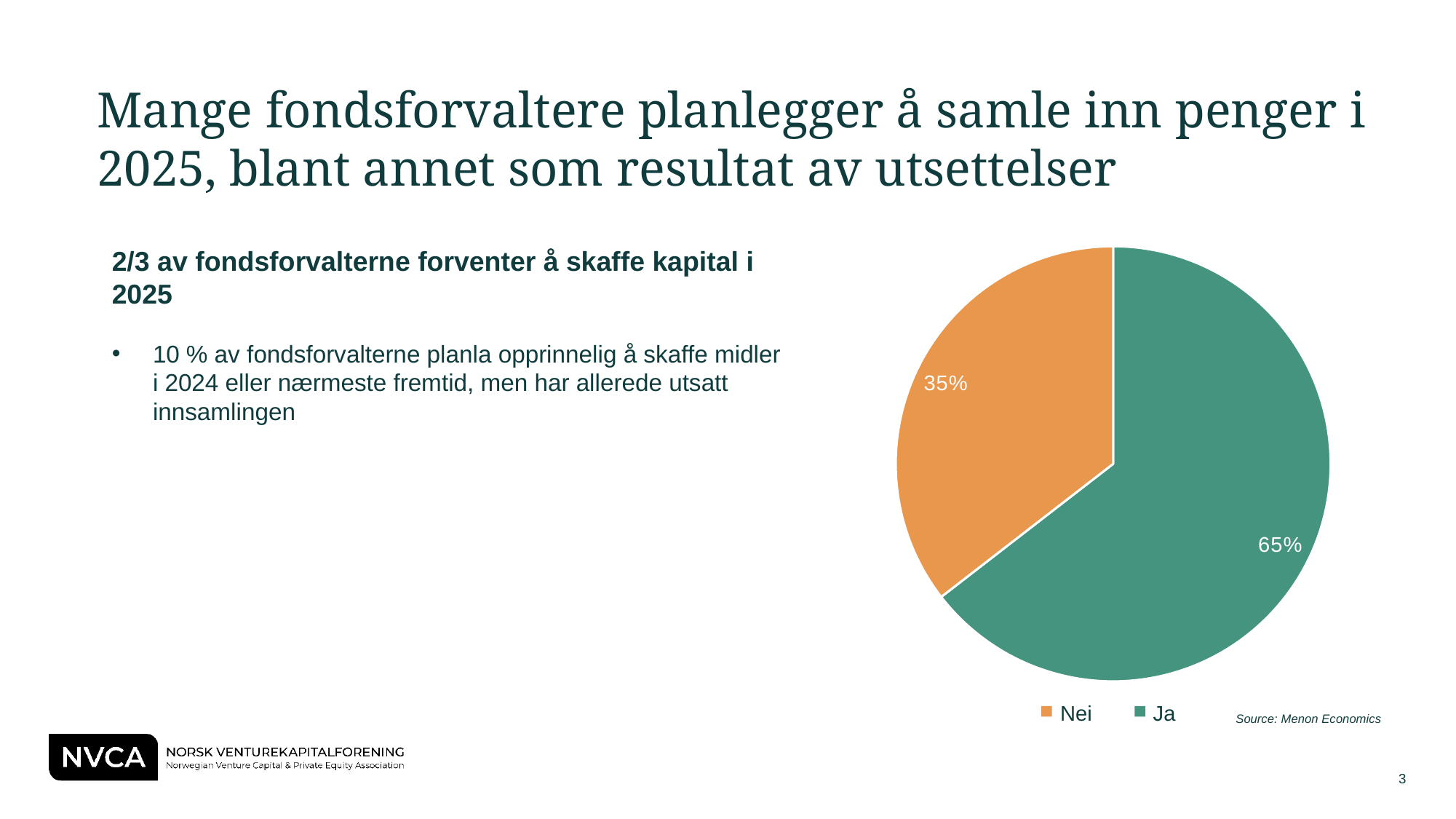
What is the difference in percentage points between the "Ja" and "Nei" slices? 30 percentage points What source is cited below the pie chart? Menon Economics Which slice of the pie is the smallest? Nei What share of the pie does the "Ja" slice represent? 65% Which slice of the pie is the largest? Ja What colour is the "Nei" slice in the pie chart? Orange How many slices does the pie chart have? 2 Which is larger, the "Ja" slice or the "Nei" slice? Ja What kind of chart is shown on the slide? Pie chart What share of the pie does the "Nei" slice represent? 35% How many entries does the legend list? 2